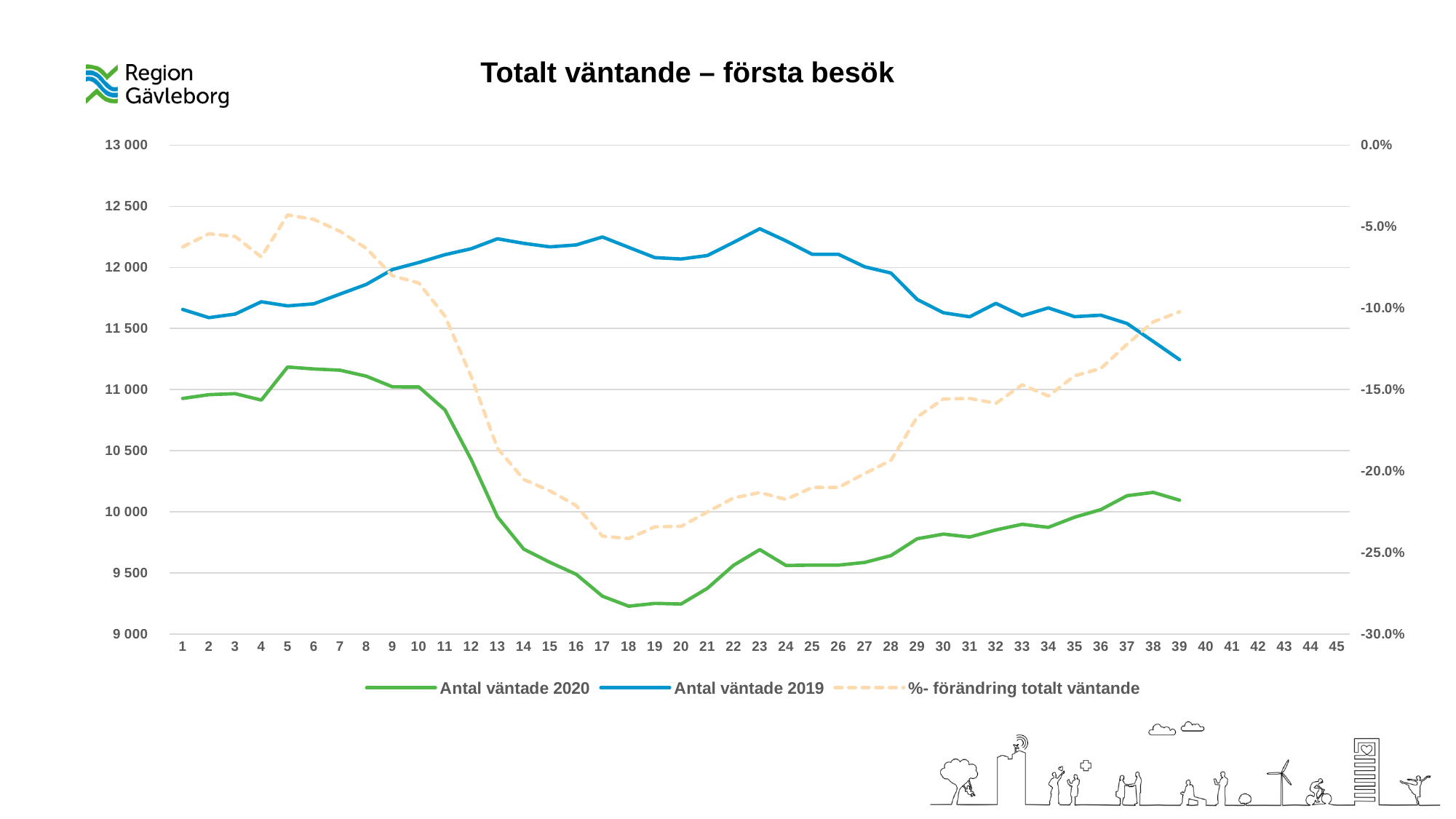
Is the value for Antal väntade 2020 at week 5 greater or less than 11 000? greater At week 10, which series has the higher value, Antal väntade 2019 or Antal väntade 2020? Antal väntade 2019 How many series does the legend list? 3 What is the last week number on the x axis that has plotted data? 39 Is the value for %- förändring totalt väntande at week 17 greater or less than -20.0%? less Is the value for Antal väntade 2019 at week 23 greater or less than 12 000? greater What is the title of the chart? Totalt väntande – första besök What kind of chart is shown on the slide? line chart Does Antal väntade 2020 rise or fall from week 18 to week 38? rise Which series is drawn with a dashed line? %- förändring totalt väntande At which week does Antal väntade 2019 reach its highest value? 23